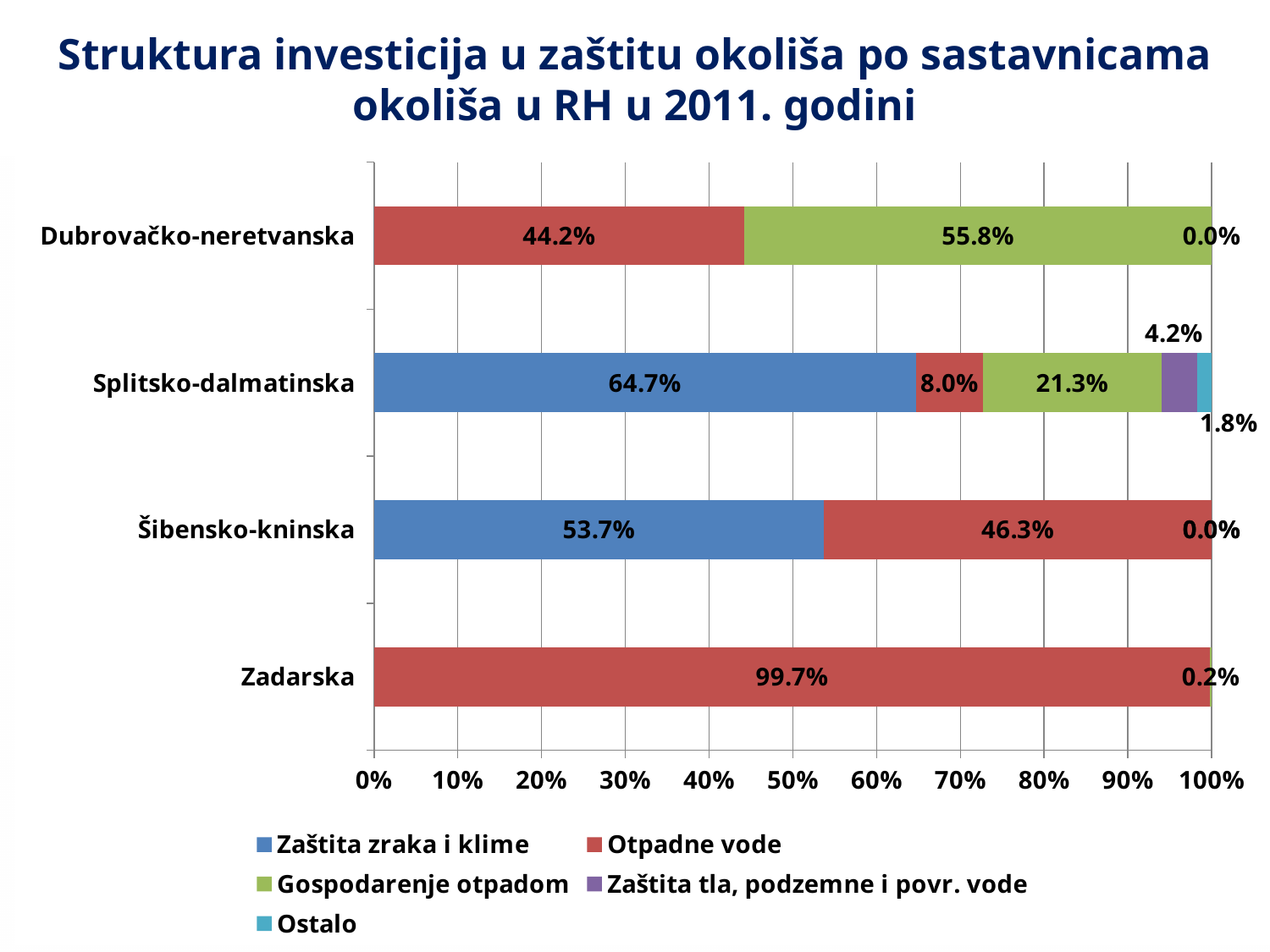
What is the difference between the Zaštita zraka i klime shares of Splitsko-dalmatinska and Šibensko-kninska? 11.0% What kind of chart is shown on the slide? Stacked bar chart What is the share of Otpadne vode for Šibensko-kninska? 46.3% Which county has the lowest share of Otpadne vode? Splitsko-dalmatinska Which county has the highest share of Otpadne vode? Zadarska How many series does the legend list? 5 How many counties (categories) are shown on the chart? 4 What is the share of Zaštita zraka i klime for Splitsko-dalmatinska? 64.7% What is the share of Gospodarenje otpadom for Dubrovačko-neretvanska? 55.8% What is the share of Zaštita tla, podzemne i povr. vode for Splitsko-dalmatinska? 4.2% What is the share of Otpadne vode for Zadarska? 99.7% Which is larger for Dubrovačko-neretvanska: the share of Otpadne vode or the share of Gospodarenje otpadom? Gospodarenje otpadom